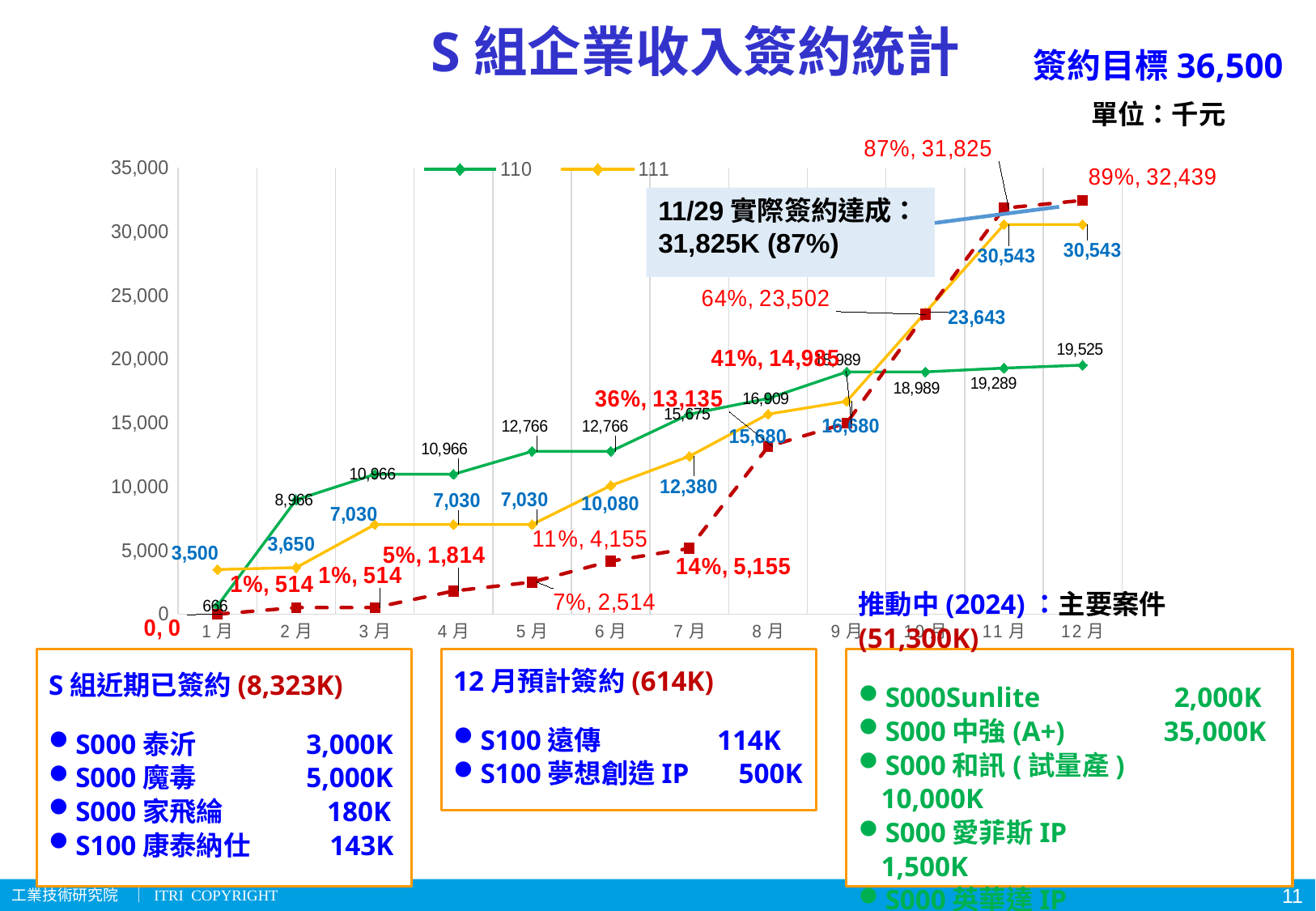
In 5月, which series has the larger value, 110 or 111? 110 How many months are shown along the x axis of the chart? 12 What is the value of series 110 in 2月? 8,966 Does series 111 generally rise or fall from 1月 to 12月? rise What is the value of series 111 in 11月? 30,543 In which month does series 110 reach its highest value? 12月 How many series does the chart legend list? 2 What is the difference between series 111 and series 110 in 12月? 11,018 In which month is series 111 at its lowest value? 1月 What kind of chart is shown on the slide? line chart What is the value of series 110 in 12月? 19,525 What is the value of series 111 in 7月? 12,380